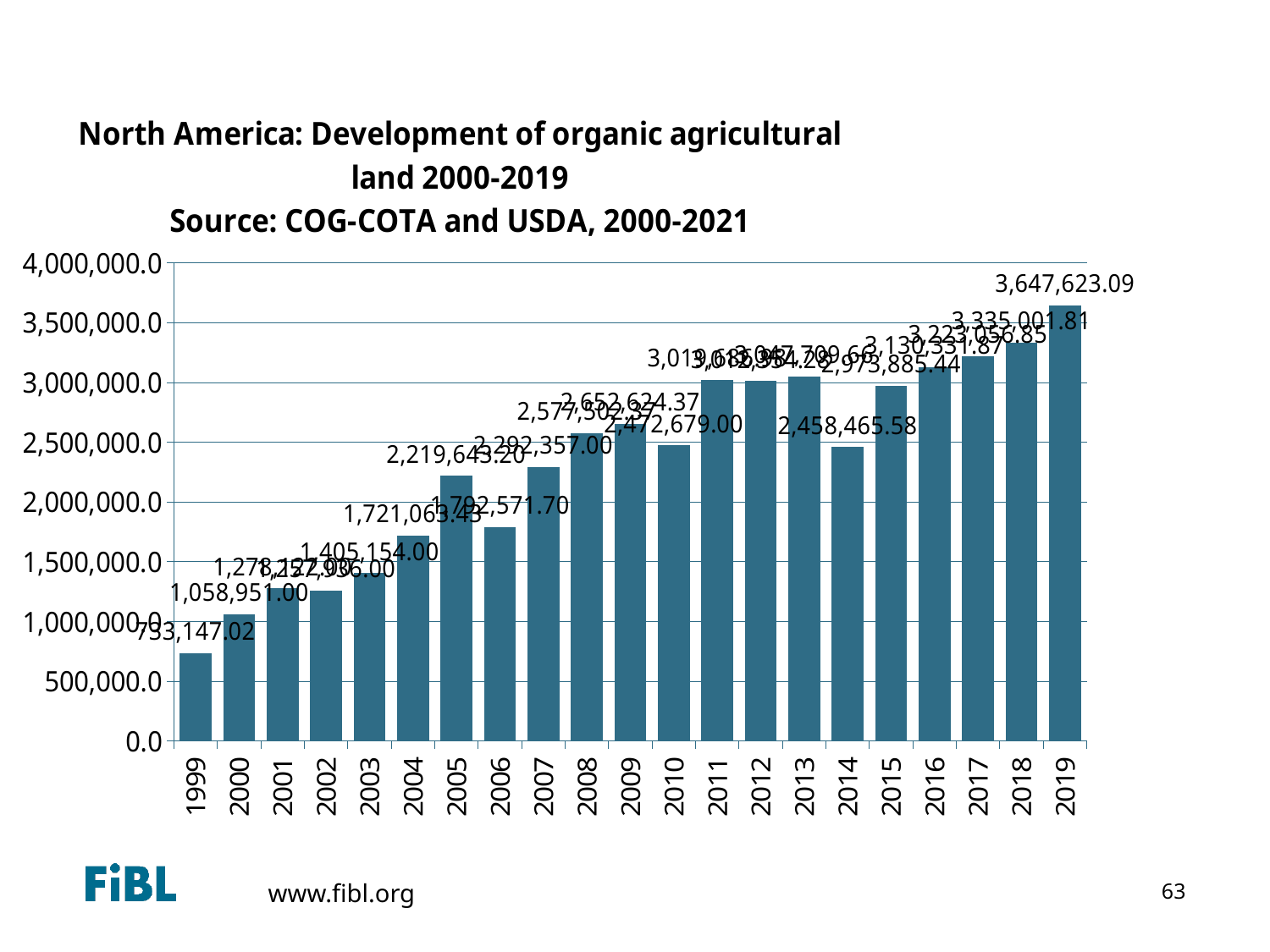
How many years (bars) are plotted in the chart? 21 What is the value shown for 2019? 3,647,623.09 What is the value shown for 2014? 2,458,465.58 Is the value for 2016 greater or less than 3,000,000? greater Which year has the smallest organic agricultural land area? 1999 What type of chart is shown on the slide? Bar chart What is the value shown for 2015? 2,973,885.44 What is the value shown for 1999? 733,147.02 According to the chart title, what is the source of the data? COG-COTA and USDA, 2000-2021 Which year has the largest organic agricultural land area? 2019 Which year has the larger value, 2005 or 2006? 2005 What is the difference between the values for 2019 and 2018? 312,621.28